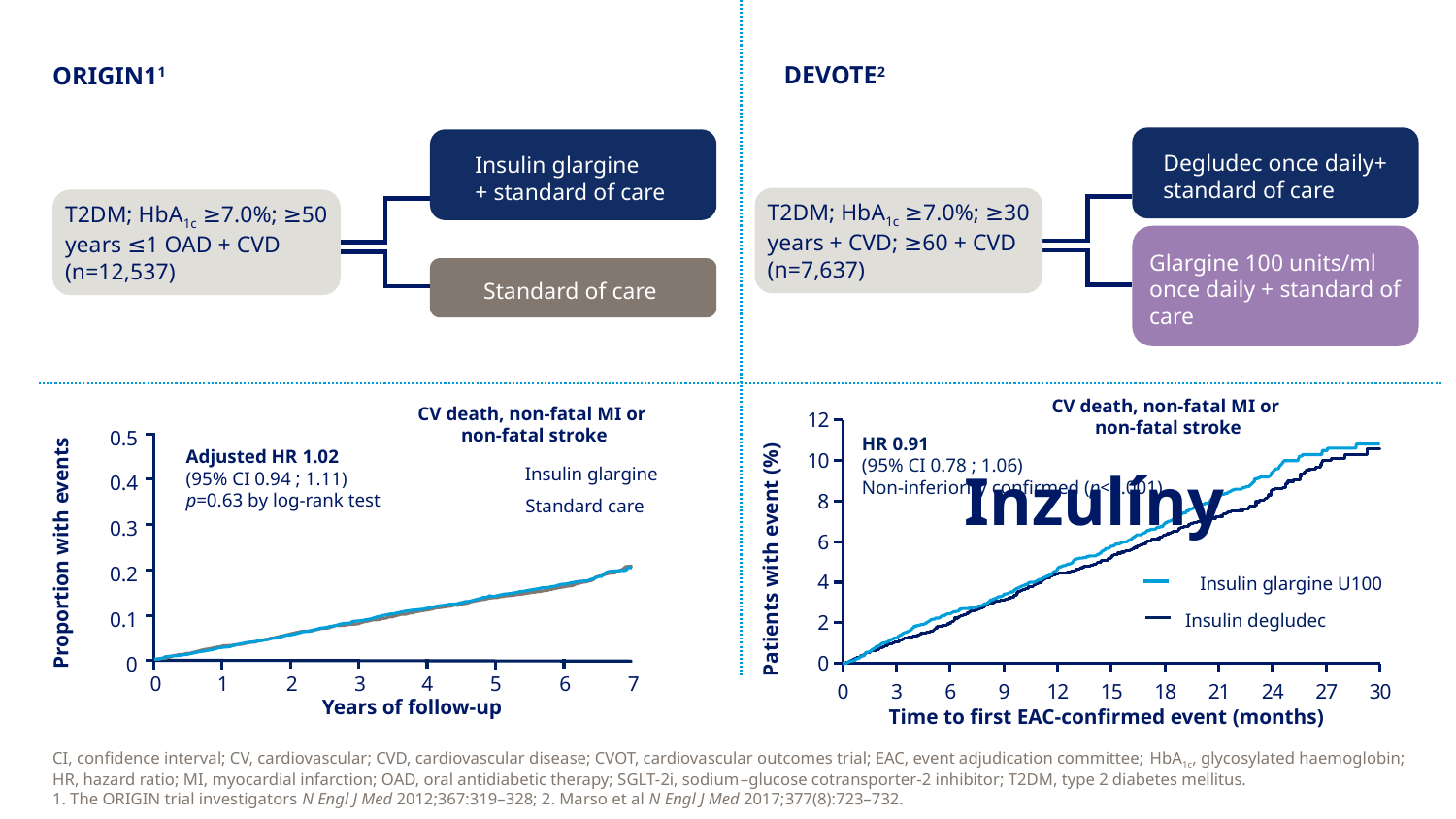
What is the x-axis label of the DEVOTE chart on the right? Time to first EAC-confirmed event (months) What adjusted hazard ratio is shown on the ORIGIN chart on the left? 1.02 In the DEVOTE chart on the right, do the plotted lines rise or fall over time? Rise In the ORIGIN chart on the left, do the plotted lines rise or fall as years of follow-up increase? Rise In the DEVOTE chart on the right, is the percentage of patients with an event for Insulin glargine U100 at 30 months greater or less than 8? greater What kind of chart is the DEVOTE chart on the right of the slide? Line chart In the ORIGIN chart on the left, is the proportion with events for Insulin glargine at 7 years greater or less than 0.3? less In the DEVOTE chart on the right, is the percentage of patients with an event for Insulin degludec at 12 months greater or less than 6? less What kind of chart is the ORIGIN chart on the left of the slide? Line chart How many series does the legend of the ORIGIN chart on the left list? 2 How many series does the legend of the DEVOTE chart on the right list? 2